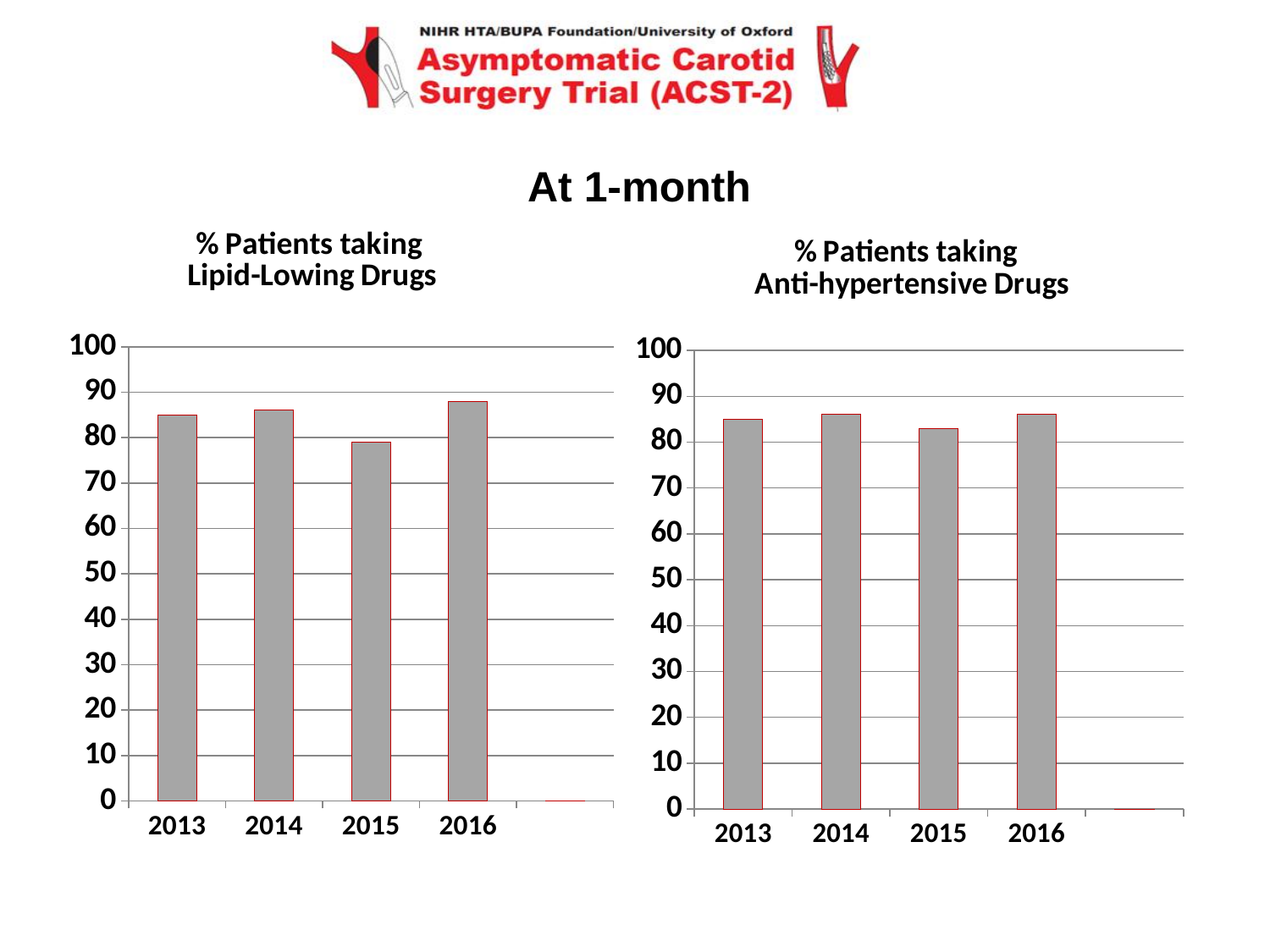
What is the title of the chart on the right of the slide? % Patients taking Anti-hypertensive Drugs In the '% Patients taking Lipid-Lowing Drugs' chart, which is larger, the value for 2016 or the value for 2015? 2016 In the '% Patients taking Lipid-Lowing Drugs' chart, is the value for 2016 greater or less than 80? greater How many years are shown on the x axis of the '% Patients taking Anti-hypertensive Drugs' chart? 4 In the '% Patients taking Anti-hypertensive Drugs' chart, is the value for 2014 greater or less than 90? less What is the heading above the two charts on the slide? At 1-month In the '% Patients taking Anti-hypertensive Drugs' chart, is the value for 2015 greater or less than 80? greater In the '% Patients taking Lipid-Lowing Drugs' chart, which is larger, the value for 2013 or the value for 2015? 2013 In the '% Patients taking Lipid-Lowing Drugs' chart, which year has the lowest value? 2015 What kind of chart is the '% Patients taking Lipid-Lowing Drugs' chart? bar chart